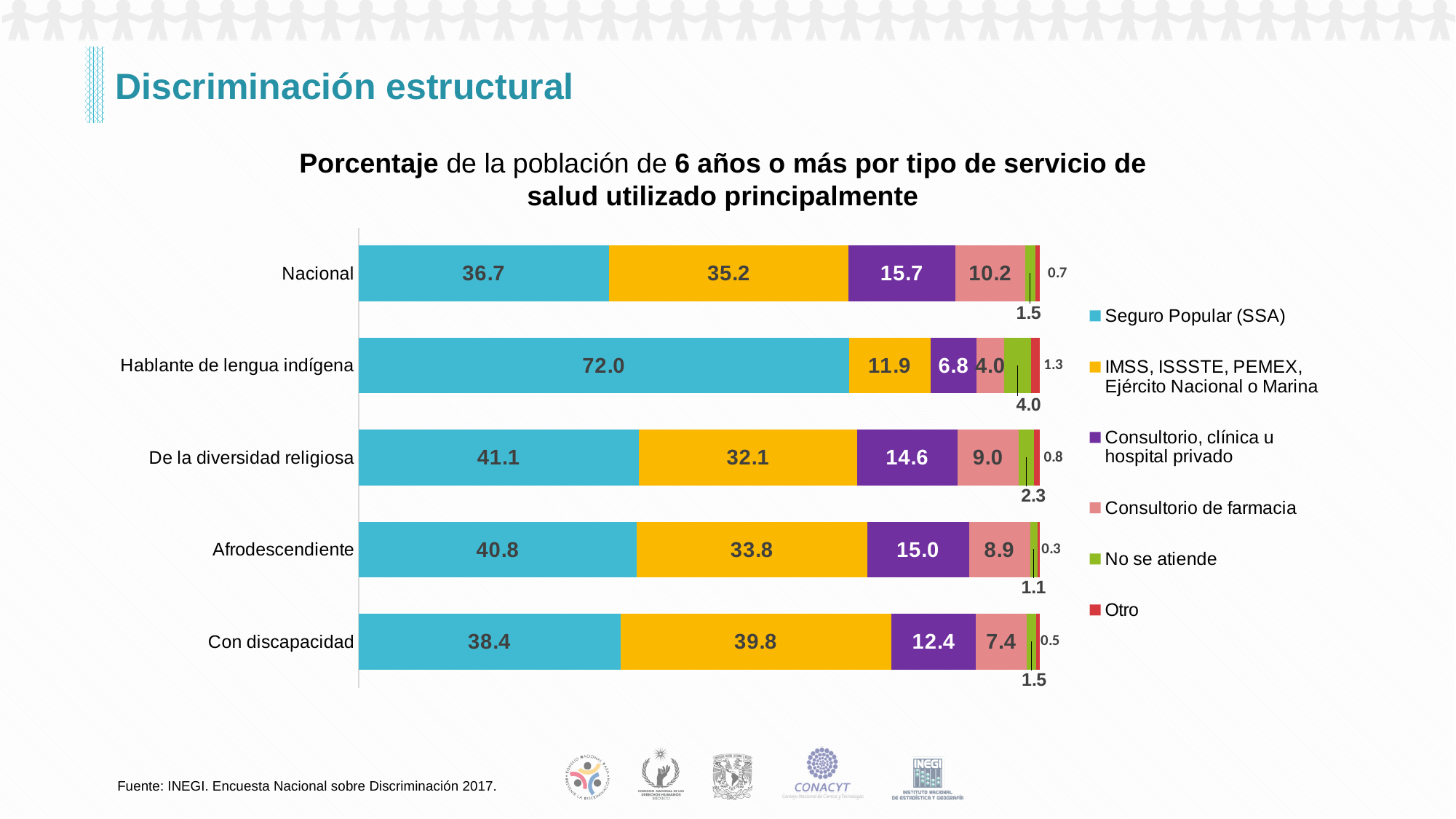
What is the Consultorio de farmacia value for Afrodescendiente? 8.9 What is the Consultorio, clínica u hospital privado value for Nacional? 15.7 Which series is shown in purple in the legend? Consultorio, clínica u hospital privado What type of chart is shown on the slide? Stacked bar chart How many series does the legend list? 6 What is the IMSS, ISSSTE, PEMEX, Ejército Nacional o Marina value for Con discapacidad? 39.8 Which group has the highest Seguro Popular (SSA) value? Hablante de lengua indígena Which group has the lowest Consultorio, clínica u hospital privado value? Hablante de lengua indígena How many population groups (categories) are shown in the chart? 5 What is the difference between the Seguro Popular (SSA) values for De la diversidad religiosa and Nacional? 4.4 What is the Seguro Popular (SSA) value for Hablante de lengua indígena? 72.0 Which is larger for Con discapacidad: the Seguro Popular (SSA) value or the IMSS, ISSSTE, PEMEX, Ejército Nacional o Marina value? IMSS, ISSSTE, PEMEX, Ejército Nacional o Marina